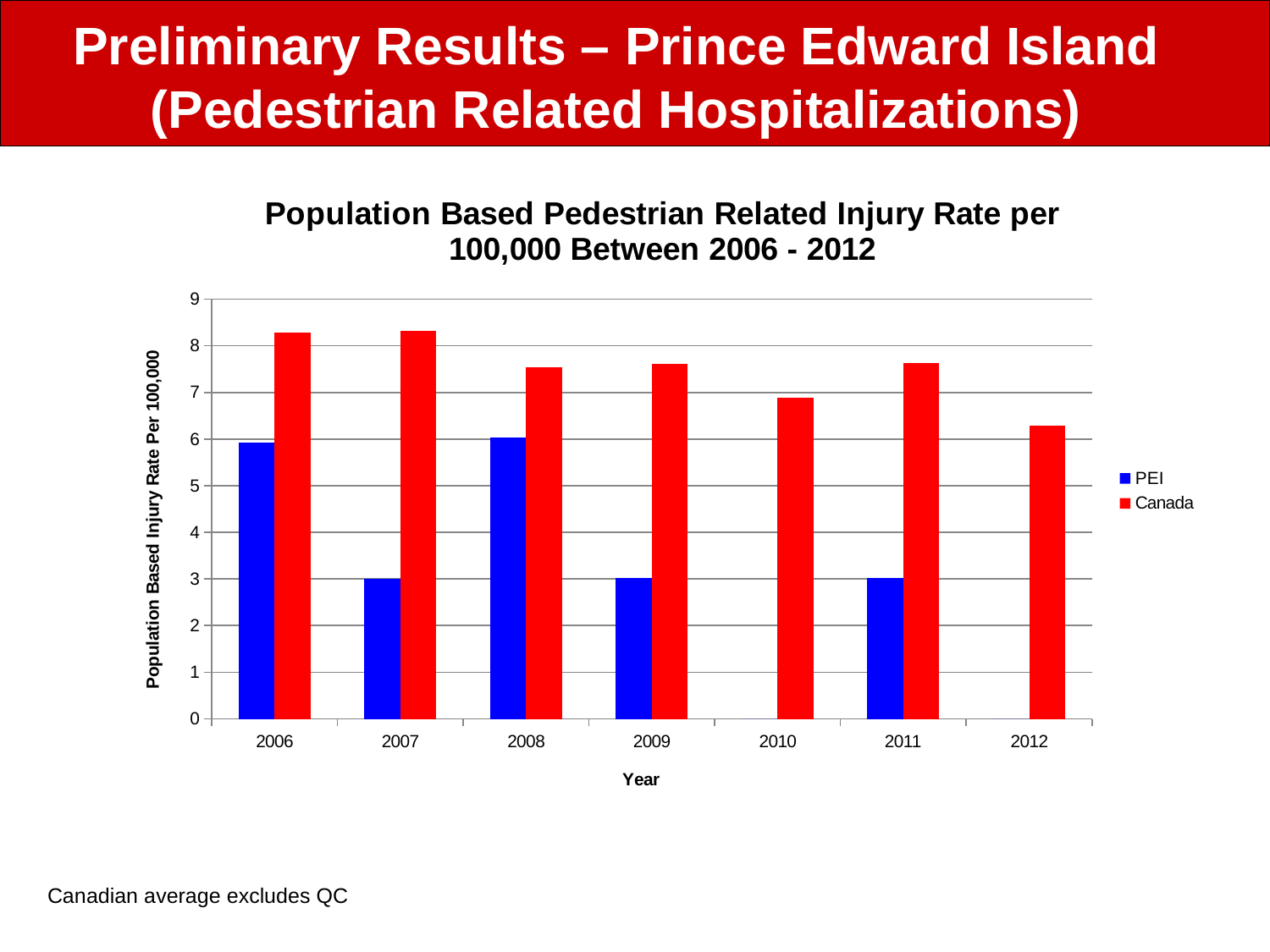
Is the PEI value for 2006 greater or less than 5? greater What kind of chart is shown on the slide? bar chart Which year has the lowest Canada injury rate? 2012 In 2006, which is larger, the PEI rate or the Canada rate? Canada Which colour represents Canada in the chart? red Is the Canada value for 2010 greater or less than 7? less Does the Canada injury rate rise or fall from 2007 to 2008? fall How many series does the legend list? 2 Which is larger, the Canada rate in 2010 or the Canada rate in 2012? 2010 How many years are shown on the x axis? 7 Is the Canada value for 2012 greater or less than 6? greater